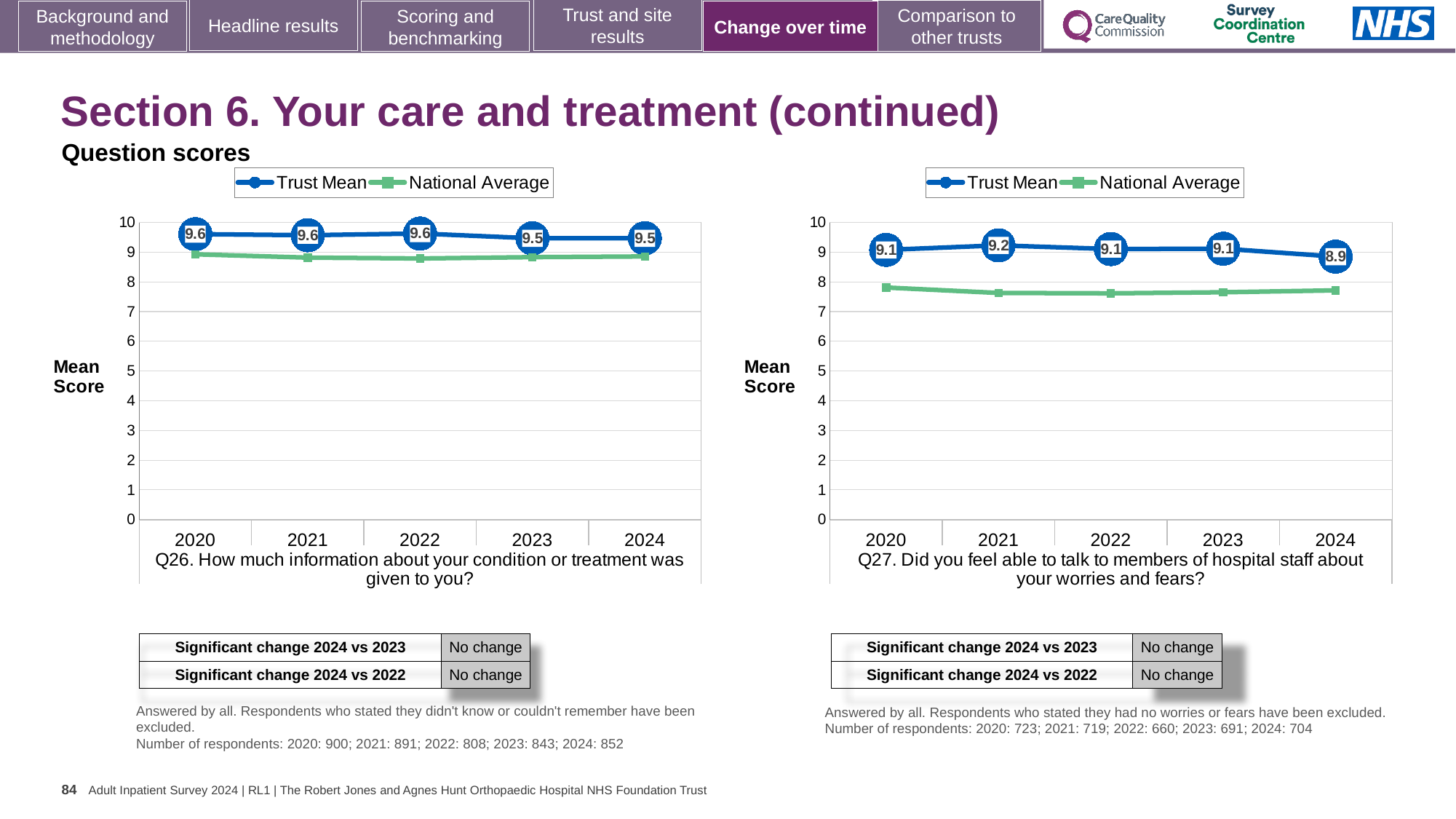
In the Q27 chart (right), what is the difference between the Trust Mean scores for 2021 and 2024? 0.3 In the Q26 chart (left), what is the Trust Mean score for 2020? 9.6 How many series does the legend of the Q27 chart (right) list? 2 In the Q27 chart (right), which year has the lowest Trust Mean score? 2024 In the Q27 chart (right), which year has the highest Trust Mean score? 2021 In the Q26 chart (left), what is the Trust Mean score for 2024? 9.5 In the Q27 chart (right), what is the Trust Mean score for 2024? 8.9 In the Q26 chart (left), is the Trust Mean or the National Average higher in 2022? Trust Mean In the Q27 chart (right), is the National Average value for 2021 greater or less than 8? less How many years are plotted on the x axis of the Q26 chart (left)? 5 What type of chart is used for Q26 (left)? Line chart In the Q27 chart (right), what is the Trust Mean score for 2021? 9.2